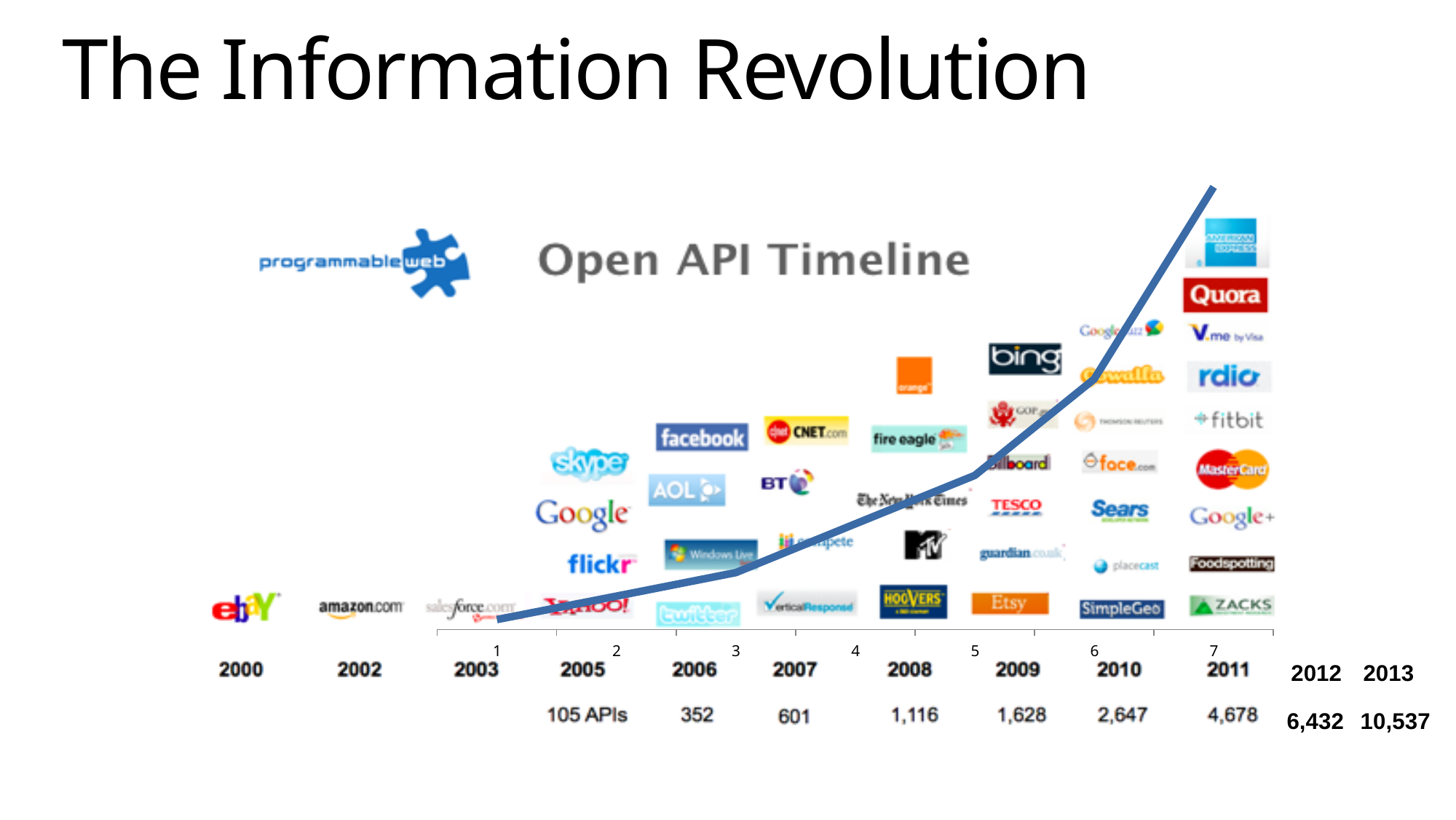
What is the number of APIs shown for 2011? 4,678 How many APIs are listed for 2005? 105 APIs Which year has the highest number of APIs shown? 2013 How many years have an API count printed beneath them? 9 Which year has more APIs, 2009 or 2010? 2010 Does the line rise or fall from left to right along the timeline? rise What is the number of APIs shown for 2008? 1,116 What is the title shown on the timeline image? Open API Timeline What is the number of APIs shown for 2013? 10,537 What kind of chart is overlaid on the Open API Timeline? line chart Which year has the lowest number of APIs shown? 2005 What is the difference between the number of APIs in 2013 and 2012? 4,105